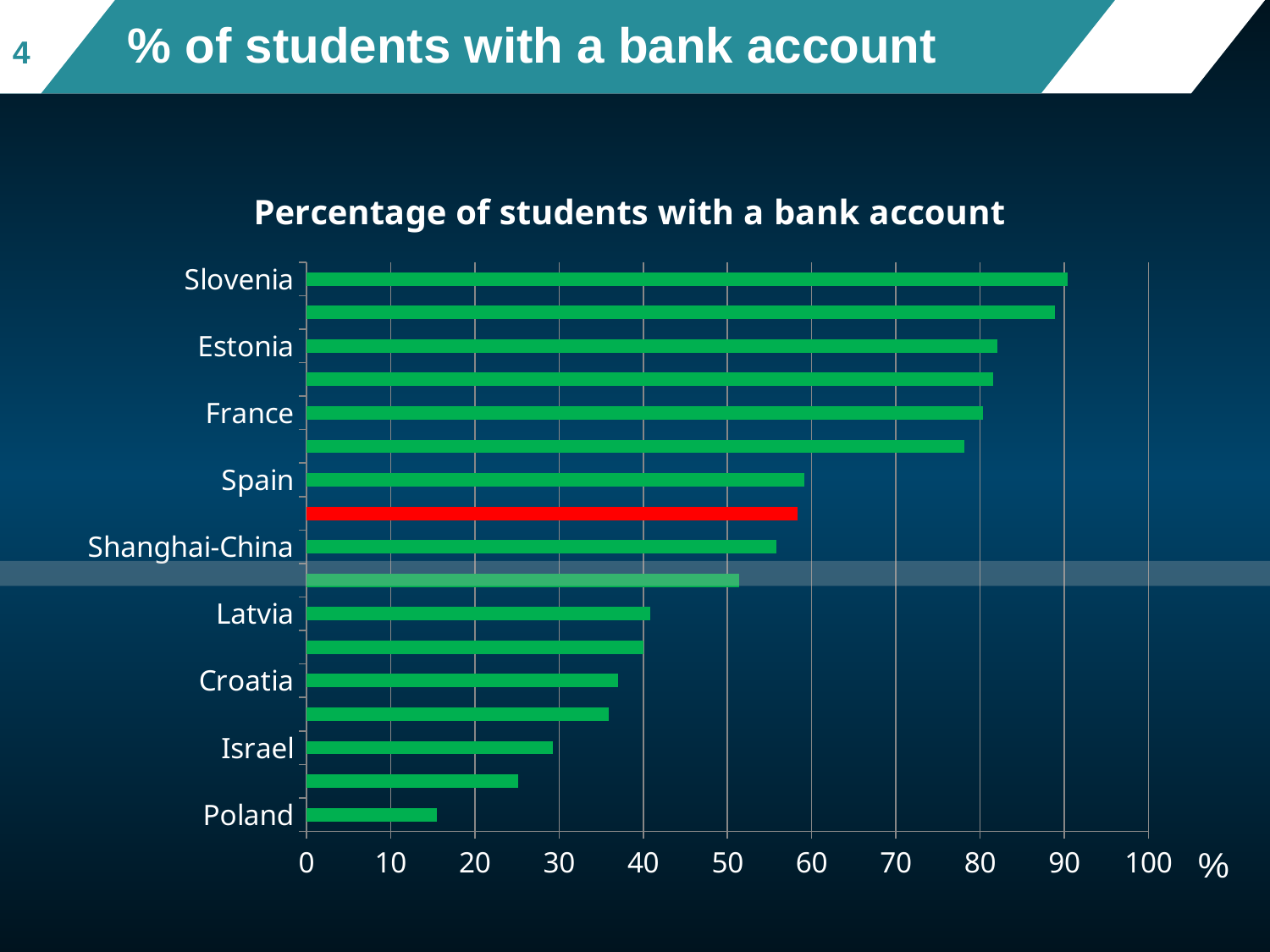
Is the value for Croatia greater or less than 40? less Which has a higher percentage of students with a bank account, Spain or Latvia? Spain Is the value for Latvia greater or less than 50? less What kind of chart is shown on the slide? bar chart Which labelled country has the highest percentage of students with a bank account? Slovenia Is the value for France greater or less than 70? greater Which labelled country has the lowest percentage of students with a bank account? Poland What is the title of the chart? Percentage of students with a bank account How many bars are plotted in the chart? 17